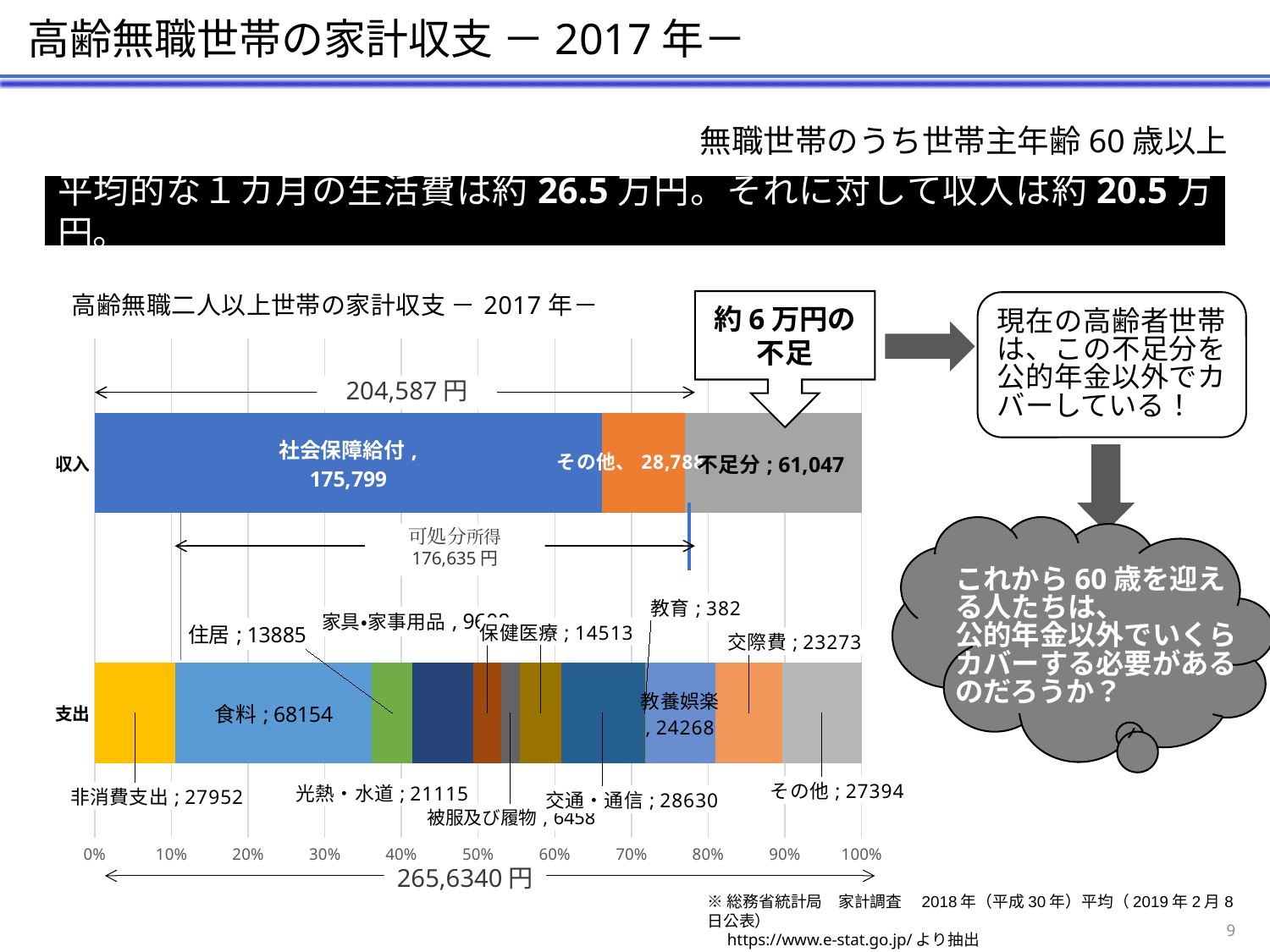
What is the value of 社会保障給付 in the 収入 bar? 175,799 Which segment of the 支出 bar has the smallest value? 教育 What is the title of the chart? 高齢無職二人以上世帯の家計収支 － 2017 年－ Which segment of the 支出 bar has the largest value? 食料 What is the value of 保健医療 in the 支出 bar? 14513 What is the value of 非消費支出 in the 支出 bar? 27952 What is the value of 不足分 in the 収入 bar? 61,047 Which is larger in the 支出 bar, 交通・通信 or 交際費? 交通・通信 How many bars (categories) does the chart show? 2 What is the value of 食料 in the 支出 bar? 68154 What is the difference between 社会保障給付 and その他 in the 収入 bar? 147,011 What type of chart is shown on the slide? bar chart